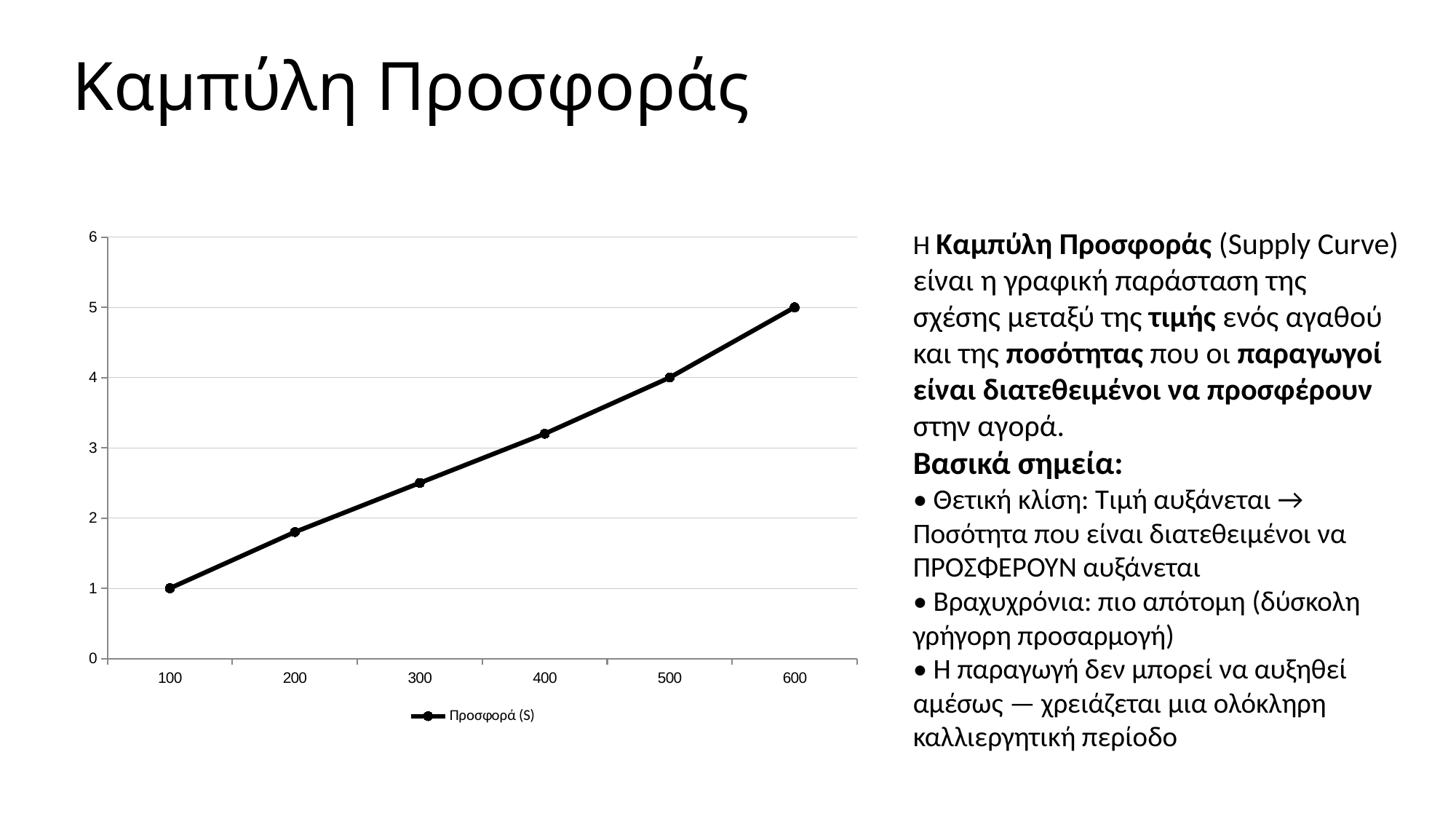
What is the value of Προσφορά (S) at x = 100? 1 What is the value of Προσφορά (S) at x = 500? 4 Is the value for x = 400 greater or less than 3? greater What is the value of Προσφορά (S) at x = 600? 5 Do the values rise or fall as x increases from 100 to 600? rise At which x value is Προσφορά (S) lowest? 100 How many data points are plotted on the line? 6 How many series does the legend list? 1 At which x value is Προσφορά (S) highest? 600 What is the name of the series shown in the legend? Προσφορά (S) What kind of chart is shown on the slide? line chart Is the value for x = 200 greater or less than 2? less